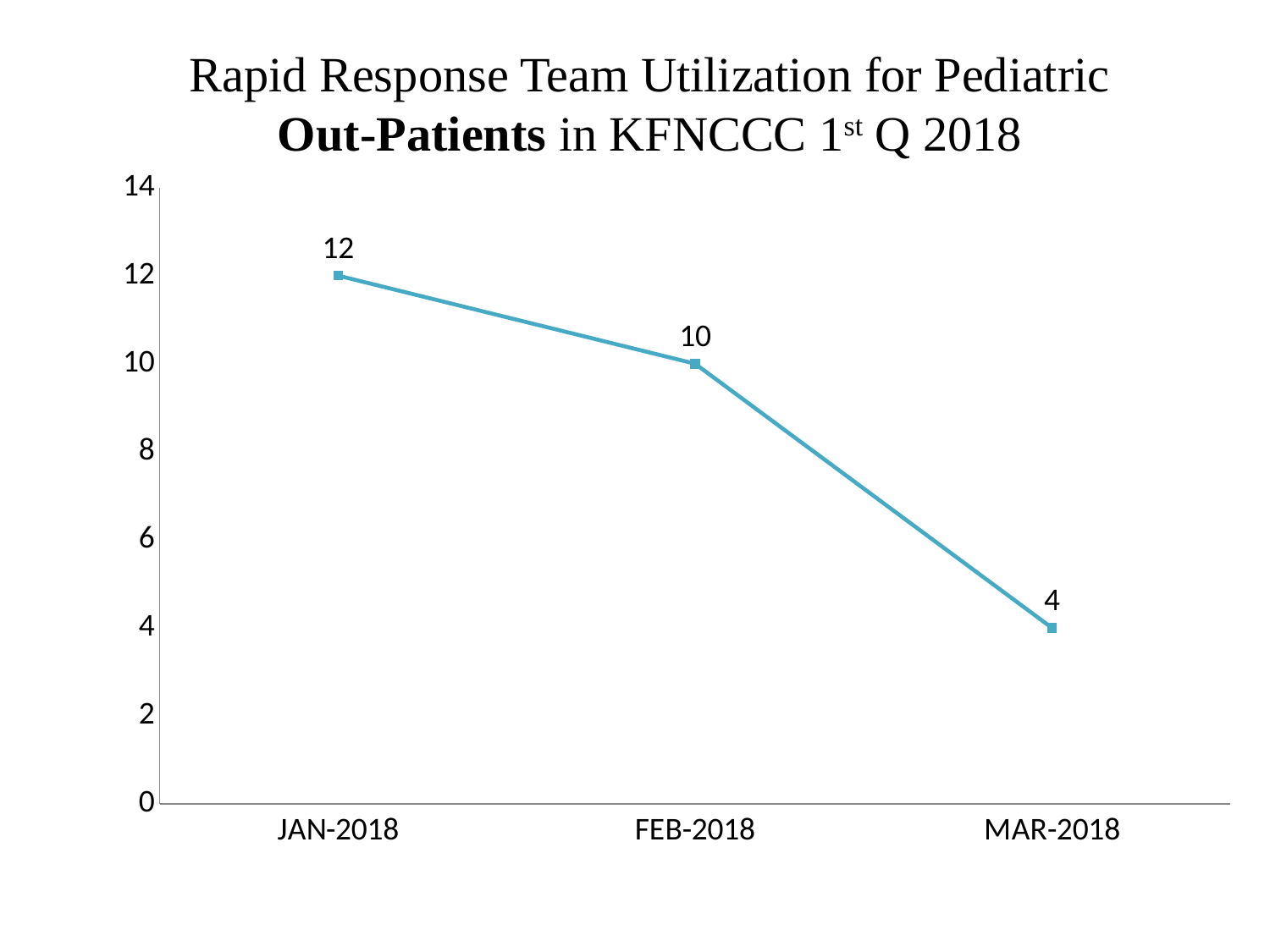
What is the value for MAR-2018? 4 Is the value for MAR-2018 greater or less than 6? less Which month has the highest value? JAN-2018 What is the difference between the values for JAN-2018 and MAR-2018? 8 What is the difference between the values for FEB-2018 and MAR-2018? 6 Which month has the lowest value? MAR-2018 What is the value for FEB-2018? 10 Which is larger, the value for FEB-2018 or the value for MAR-2018? FEB-2018 How many months are plotted on the chart? 3 What is the value for JAN-2018? 12 Do the values rise or fall from JAN-2018 to MAR-2018? fall What kind of chart is shown on the slide? line chart